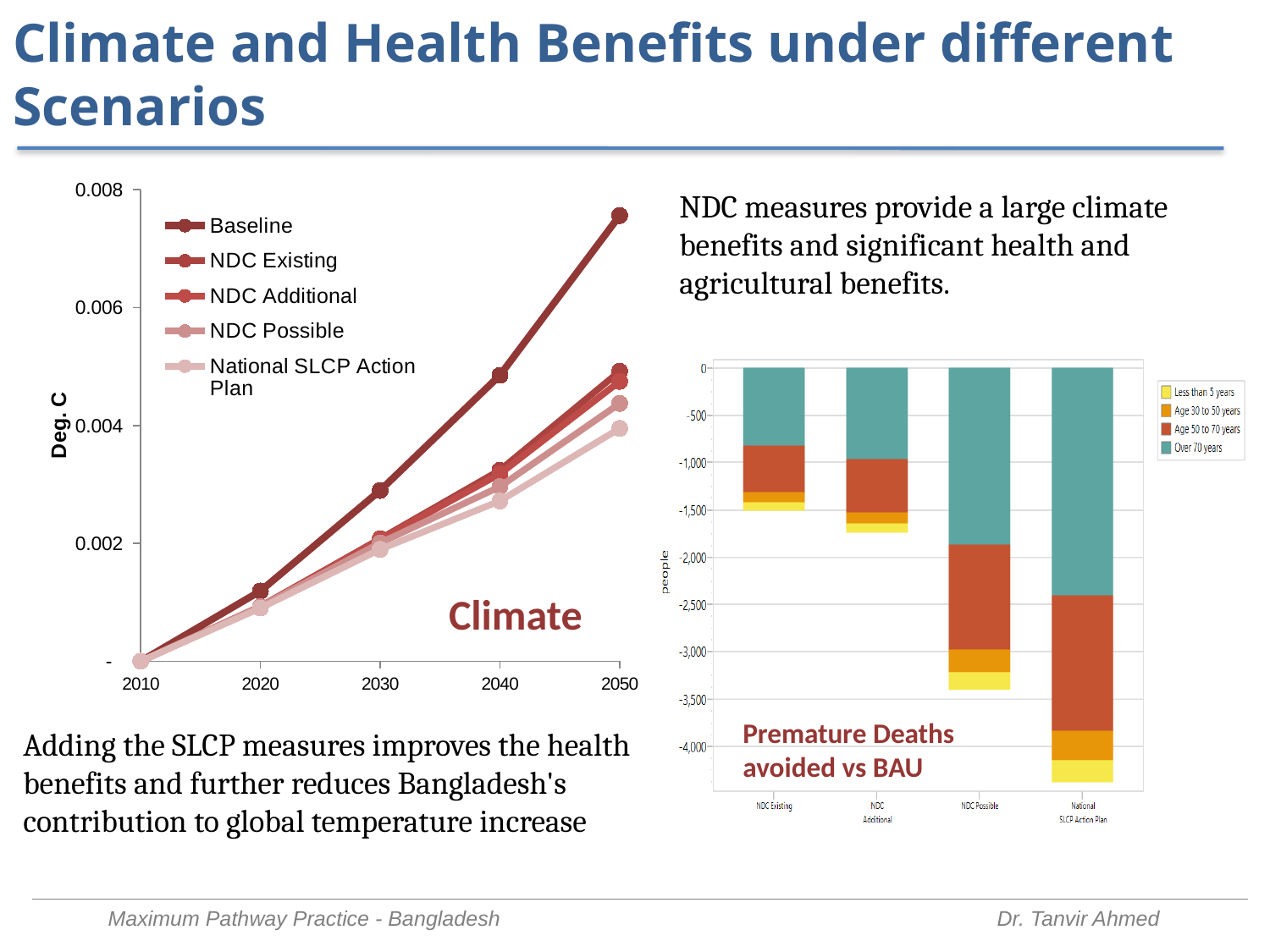
In the Climate chart, do the values rise or fall from 2010 to 2050? Rise In the Climate chart, is the NDC Existing value in 2050 greater or less than 0.006? less How many scenarios are shown on the x axis of the Premature Deaths avoided vs BAU chart? 4 In the Climate chart, which series has the lowest value in 2050? National SLCP Action Plan In the Climate chart, is the Baseline value in 2050 greater or less than 0.006? greater How many years are marked on the x axis of the Climate chart? 5 What kind of chart is the Climate chart on the left? Line chart What kind of chart is the Premature Deaths avoided vs BAU chart on the right? Bar chart In the Climate chart, which series has the highest value in 2050? Baseline In the Premature Deaths avoided vs BAU chart, which scenario has the largest bar? National SLCP Action Plan How many series does the legend of the Climate chart list? 5 In the Climate chart, which is larger in 2040: Baseline or NDC Possible? Baseline